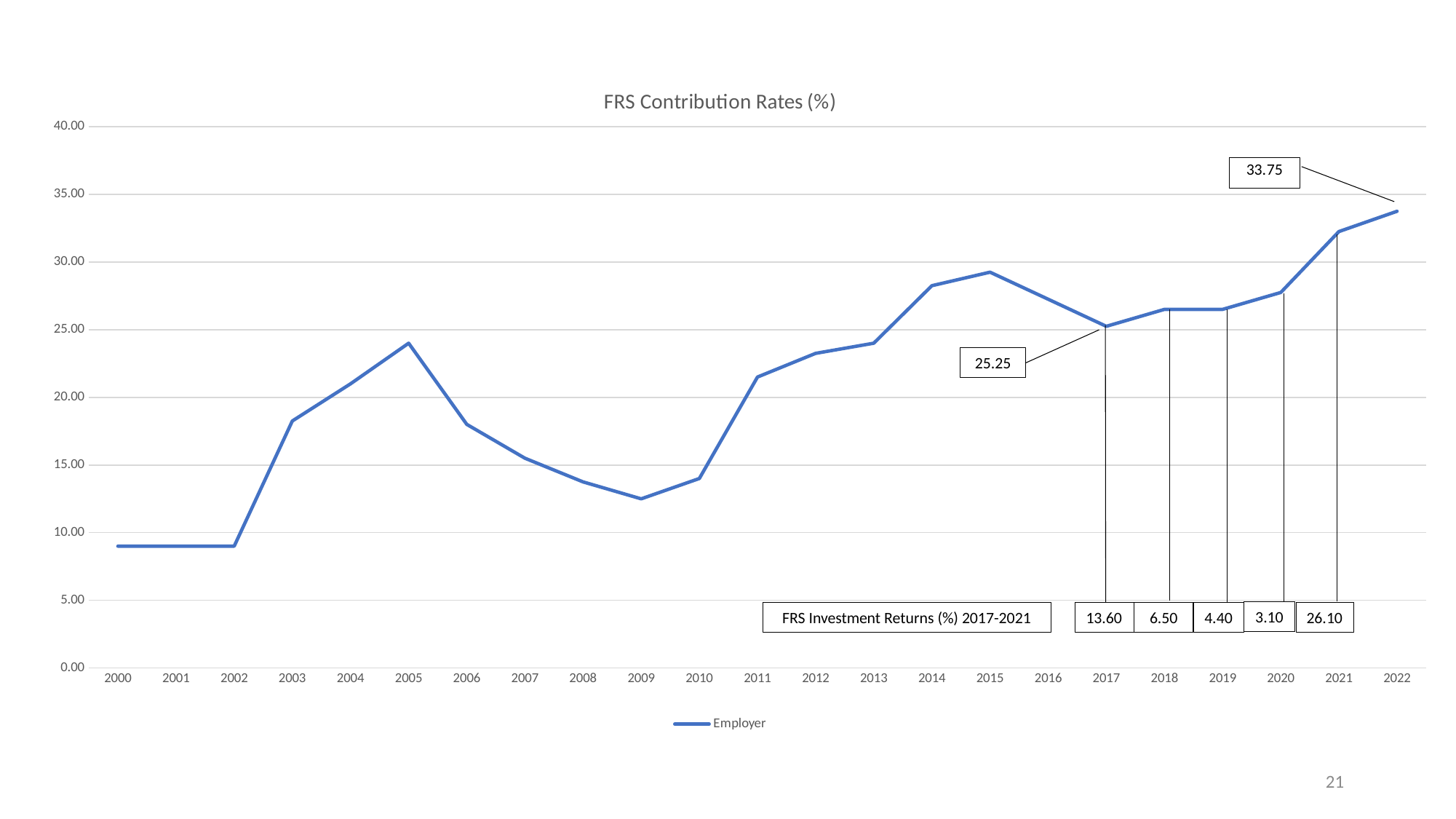
By how much did the Employer contribution rate increase from 2017 to 2022? 8.50 What is the Employer contribution rate for 2022? 33.75 What kind of chart is shown on the slide? line chart What is the title of the chart? FRS Contribution Rates (%) Which year has the larger Employer contribution rate, 2005 or 2015? 2015 Which year has the highest Employer contribution rate? 2022 Is the Employer contribution rate for 2015 greater or less than 25.00? greater How many years are shown on the x axis? 23 Does the Employer contribution rate rise or fall from 2005 to 2009? fall Is the Employer contribution rate for 2009 greater or less than 15.00? less What is the Employer contribution rate for 2017? 25.25 How many series does the legend list? 1